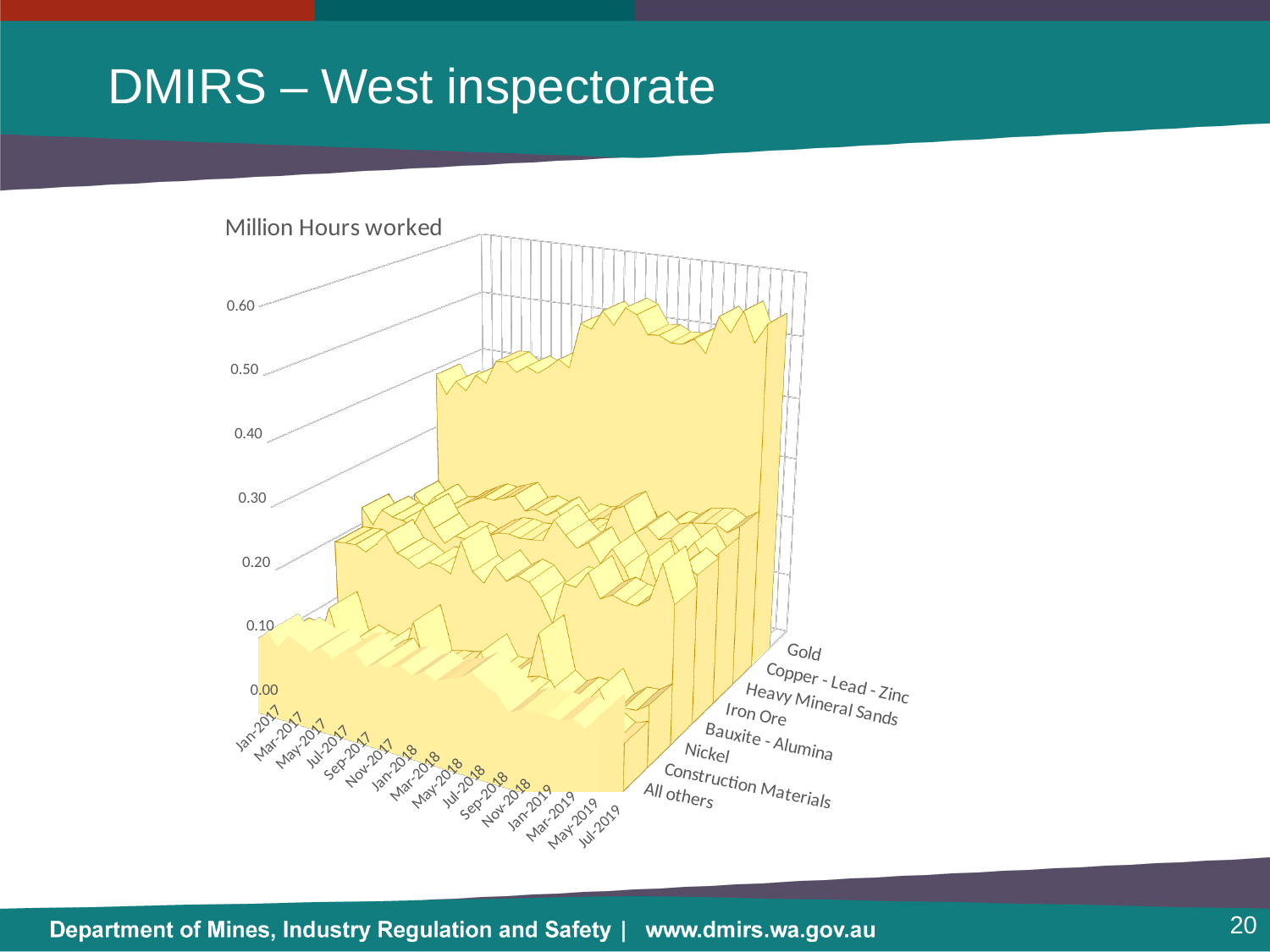
What is the highest value labelled on the vertical axis? 0.60 What is the title of the chart? Million Hours worked How many commodity series are shown on the chart's depth axis? 8 What is the last month label on the x axis? Jul-2019 Which commodity series is listed at the front of the depth axis? All others How many month labels are shown along the x axis? 16 Which commodity series has the highest hours worked on the chart? Gold Which series is larger, Gold or Nickel? Gold What is the first month label on the x axis? Jan-2017 What kind of chart is shown on the slide? 3D area (surface) chart